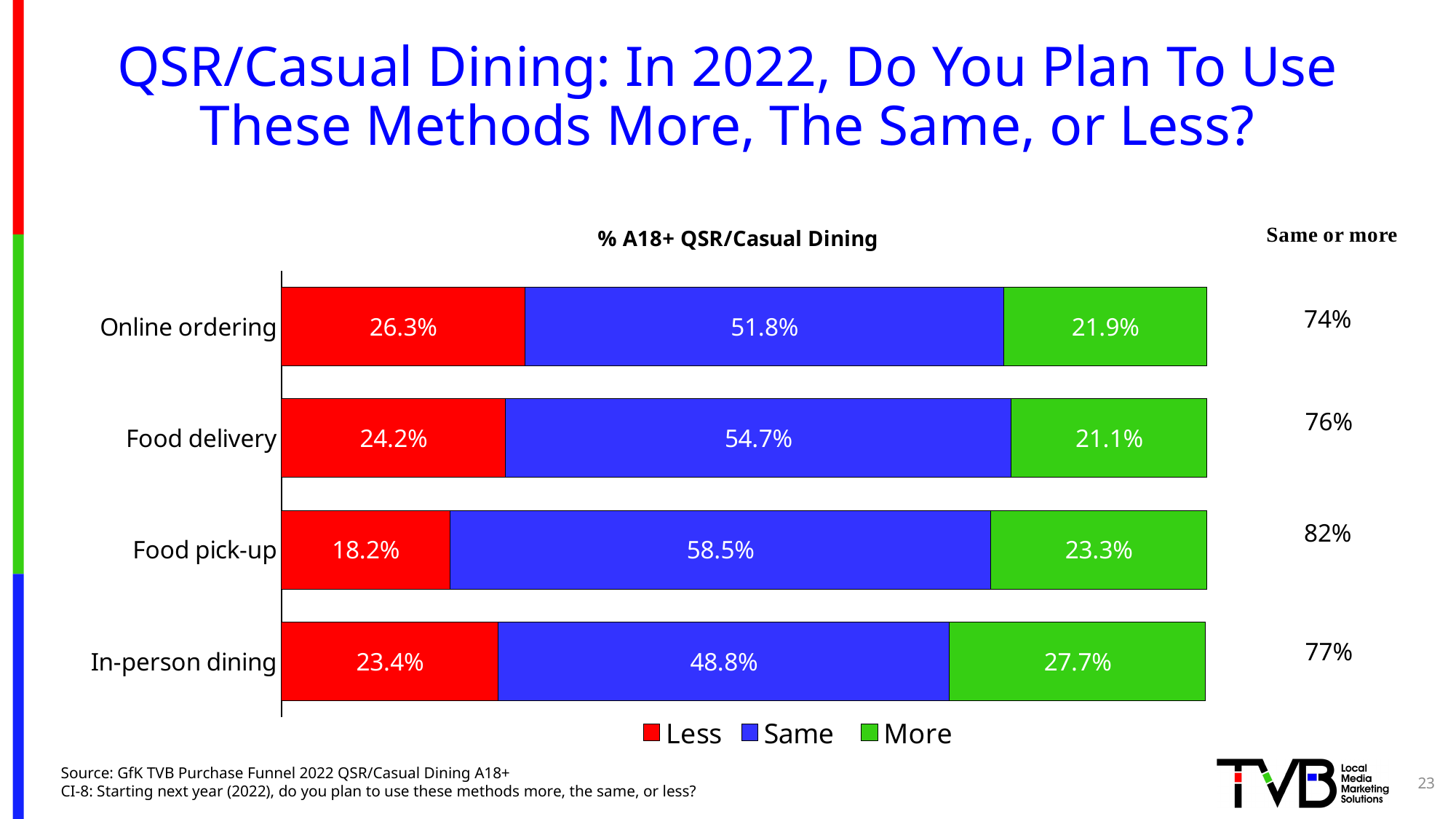
What percentage of A18+ plan to use online ordering the same amount in 2022? 51.8% What kind of chart is shown on the slide? Stacked bar chart Which method has the highest 'More' percentage? In-person dining What percentage of A18+ plan to use food pick-up less in 2022? 18.2% What is the difference between the 'Same' percentages for food pick-up and in-person dining? 9.7% What percentage of A18+ plan to use in-person dining more in 2022? 27.7% Which is larger: the 'Less' percentage for online ordering or for food delivery? Online ordering What is the 'Same or more' value shown for food pick-up? 82% How many methods (categories) are shown in the chart? 4 What colour represents the 'More' series in the chart? Green Which method has the lowest 'Less' percentage? Food pick-up How many series does the legend list? 3